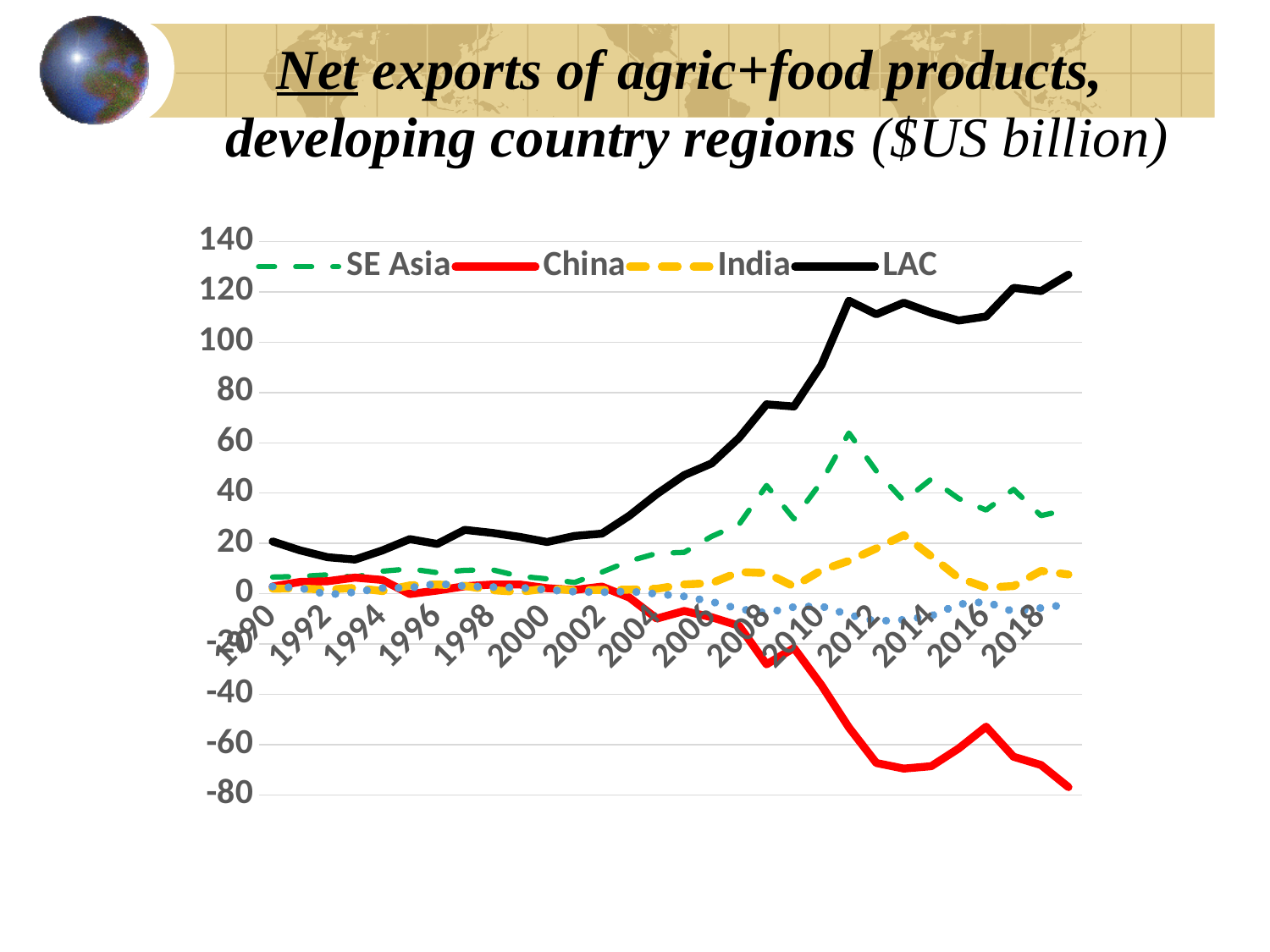
Is the value for India in 2016 greater or less than 20? less Does the China line rise or fall between 2004 and 2013? fall Is the value for China in 2019 greater or less than -60? less Is the value for SE Asia in 2012 greater or less than 40? greater In 2012, which is larger: the value for SE Asia or the value for India? SE Asia Which series has the lowest value in 2019? China Does the LAC line rise or fall between 2005 and 2011? rise How many series does the chart's legend list? 4 What colour is the LAC line in the chart? black Which series has the highest value in 2019? LAC What kind of chart is shown on the slide? line chart